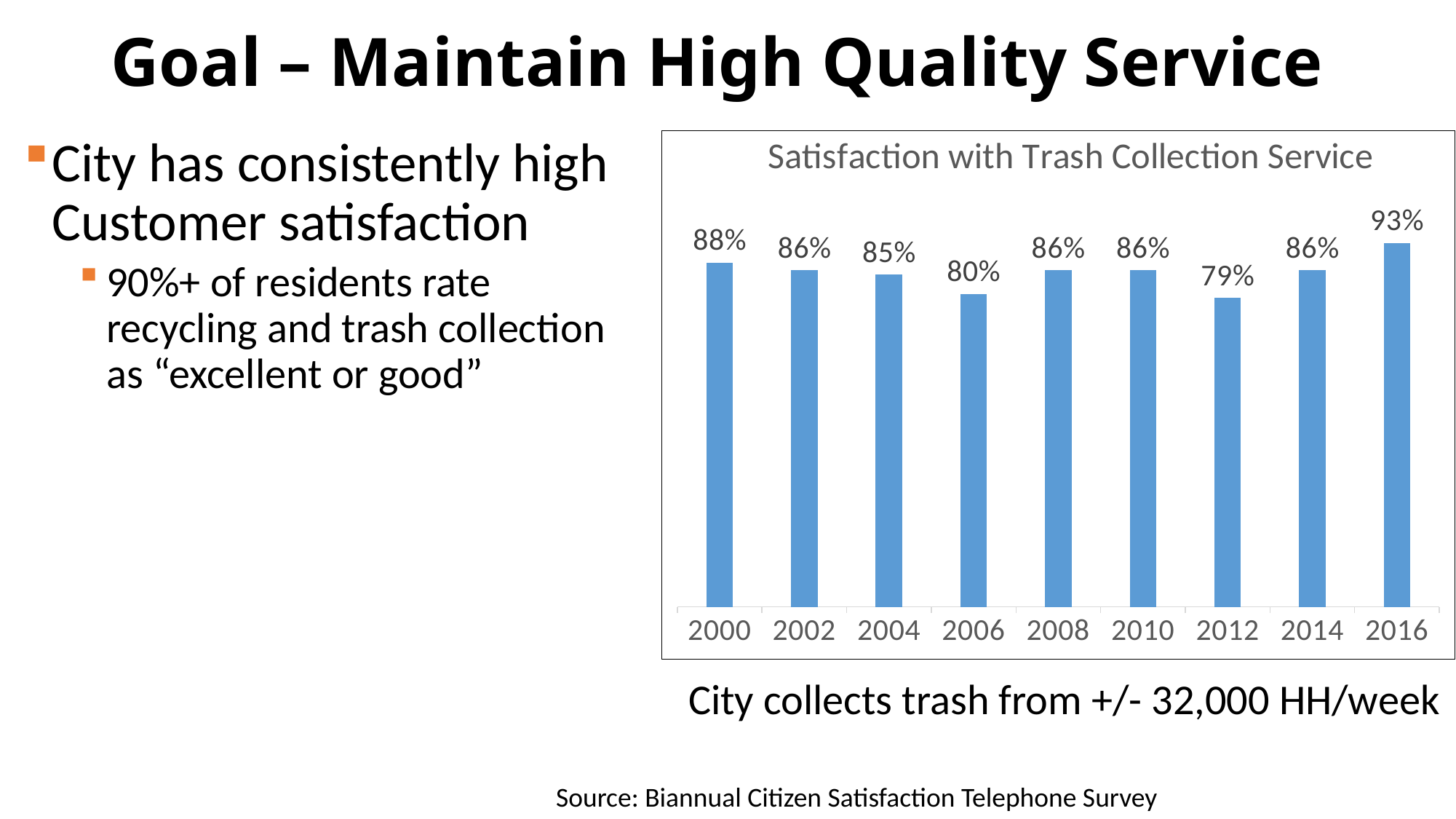
What is the satisfaction with trash collection service in 2000? 88% How many years are shown on the x axis of the chart? 9 What colour are the bars in the chart? Blue Which year has the highest satisfaction with trash collection service? 2016 What kind of chart is shown on the slide? Bar chart Which year has higher satisfaction, 2004 or 2012? 2004 What is the difference in satisfaction between 2000 and 2006? 8% What is the satisfaction with trash collection service in 2006? 80% What is the title of the chart? Satisfaction with Trash Collection Service Which year has the lowest satisfaction with trash collection service? 2012 What is the difference in satisfaction between 2016 and 2012? 14% What is the satisfaction with trash collection service in 2016? 93%